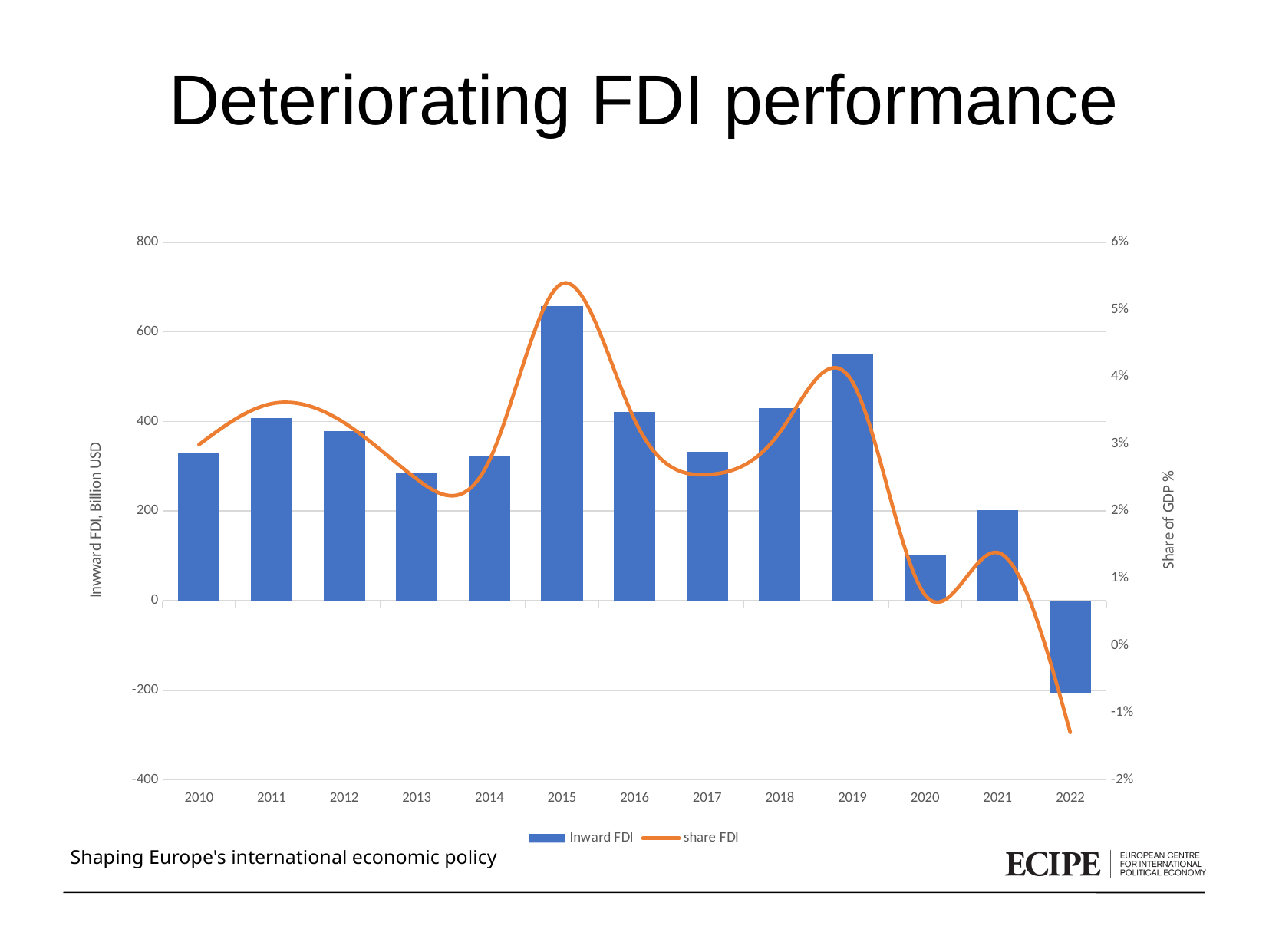
Is the Inward FDI value for 2022 greater or less than 0? less Is the Inward FDI value for 2019 greater or less than 400? greater What is the title of the chart on the slide? Deteriorating FDI performance Which year has a larger Inward FDI bar, 2020 or 2021? 2021 Which year has the lowest Inward FDI bar? 2022 How many years are shown on the x axis of the chart? 13 Which year has the highest Inward FDI bar? 2015 Is the Inward FDI value for 2015 greater or less than 600? greater How many series does the chart legend list? 2 What is the label of the left vertical axis of the chart? Inwward FDI, Billion USD Do the Inward FDI bars rise or fall from 2019 to 2022? fall